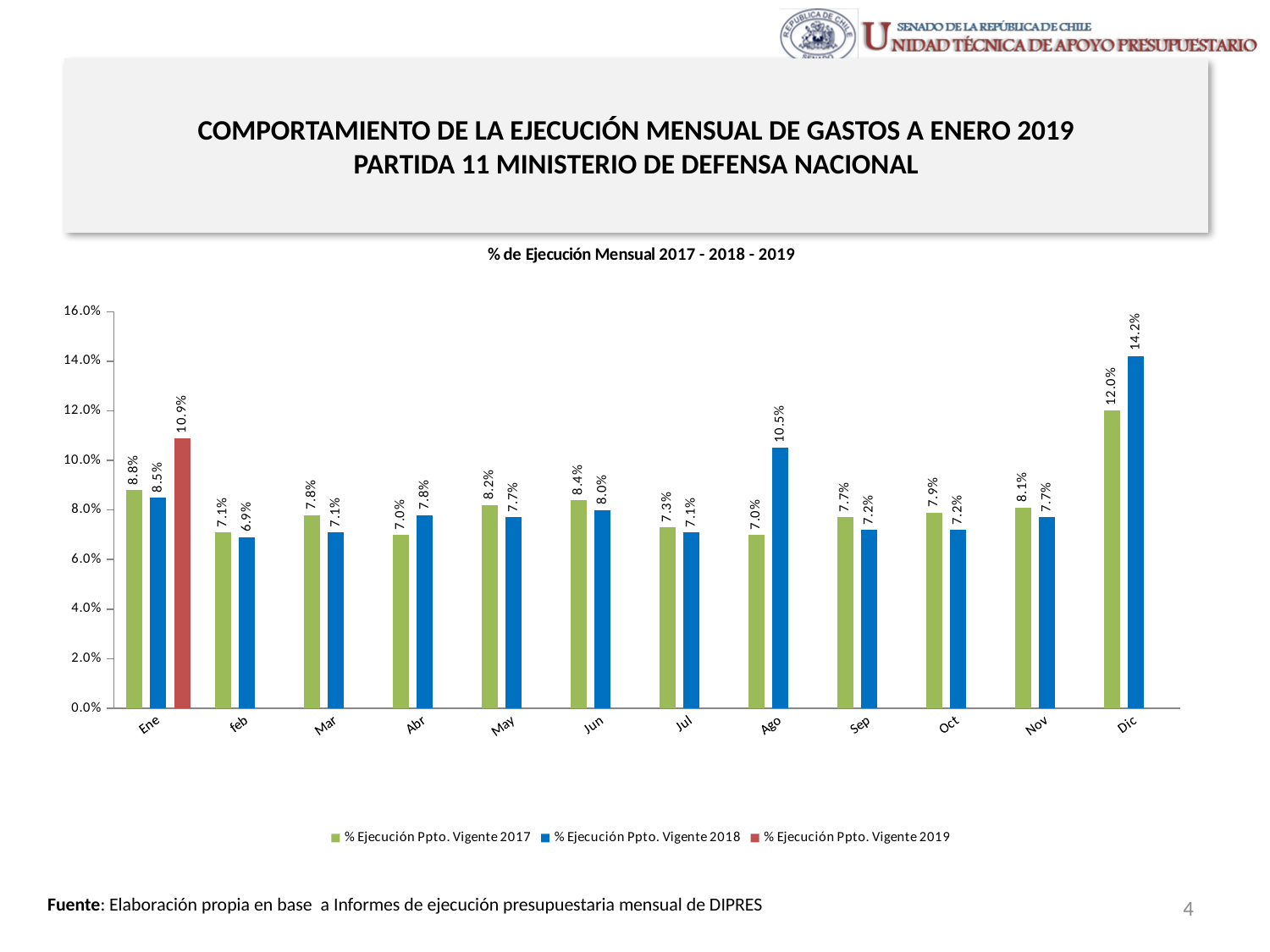
Which month has the highest % Ejecución Ppto. Vigente 2017 value? Dic Which month has the lowest % Ejecución Ppto. Vigente 2018 value? feb What is the title of the chart? % de Ejecución Mensual 2017 - 2018 - 2019 What is the % Ejecución Ppto. Vigente 2017 value for Ago? 7.0% What kind of chart is shown on the slide? Bar chart What is the % Ejecución Ppto. Vigente 2019 value for Ene? 10.9% What is the % Ejecución Ppto. Vigente 2018 value for Dic? 14.2% What is the difference between the 2018 and 2017 values for Ago? 3.5% How many months are shown on the x axis? 12 Is the % Ejecución Ppto. Vigente 2018 value for Dic greater or less than 12.0%? greater How many series does the legend list? 3 For Abr, which series is larger: % Ejecución Ppto. Vigente 2017 or % Ejecución Ppto. Vigente 2018? % Ejecución Ppto. Vigente 2018